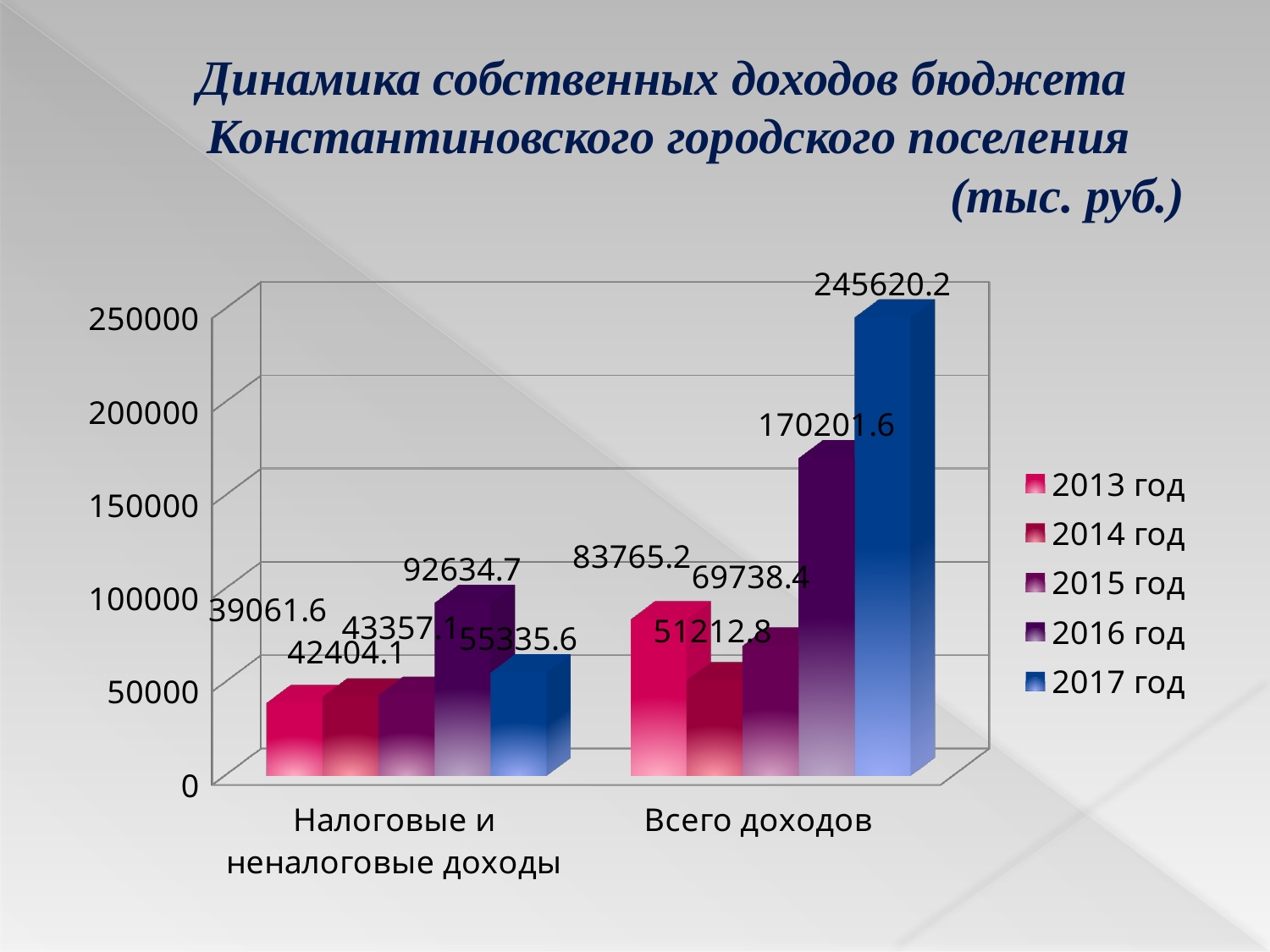
How many series does the legend list? 5 Is the value for 2016 год in the category Всего доходов greater or less than 150000? greater How many categories are shown on the x axis? 2 What is the value for 2016 год in the category Налоговые и неналоговые доходы? 92634.7 What is the value for 2014 год in the category Всего доходов? 51212.8 Which is larger in the category Всего доходов: the value for 2013 год or for 2015 год? 2013 год What type of chart is shown on the slide? Bar chart Which year has the highest value in the category Всего доходов? 2017 год Which year has the lowest value in the category Налоговые и неналоговые доходы? 2013 год What is the value for 2017 год in the category Всего доходов? 245620.2 What unit is given in the chart title? тыс. руб. What is the difference between the 2017 год and 2016 год values in the category Всего доходов? 75418.6